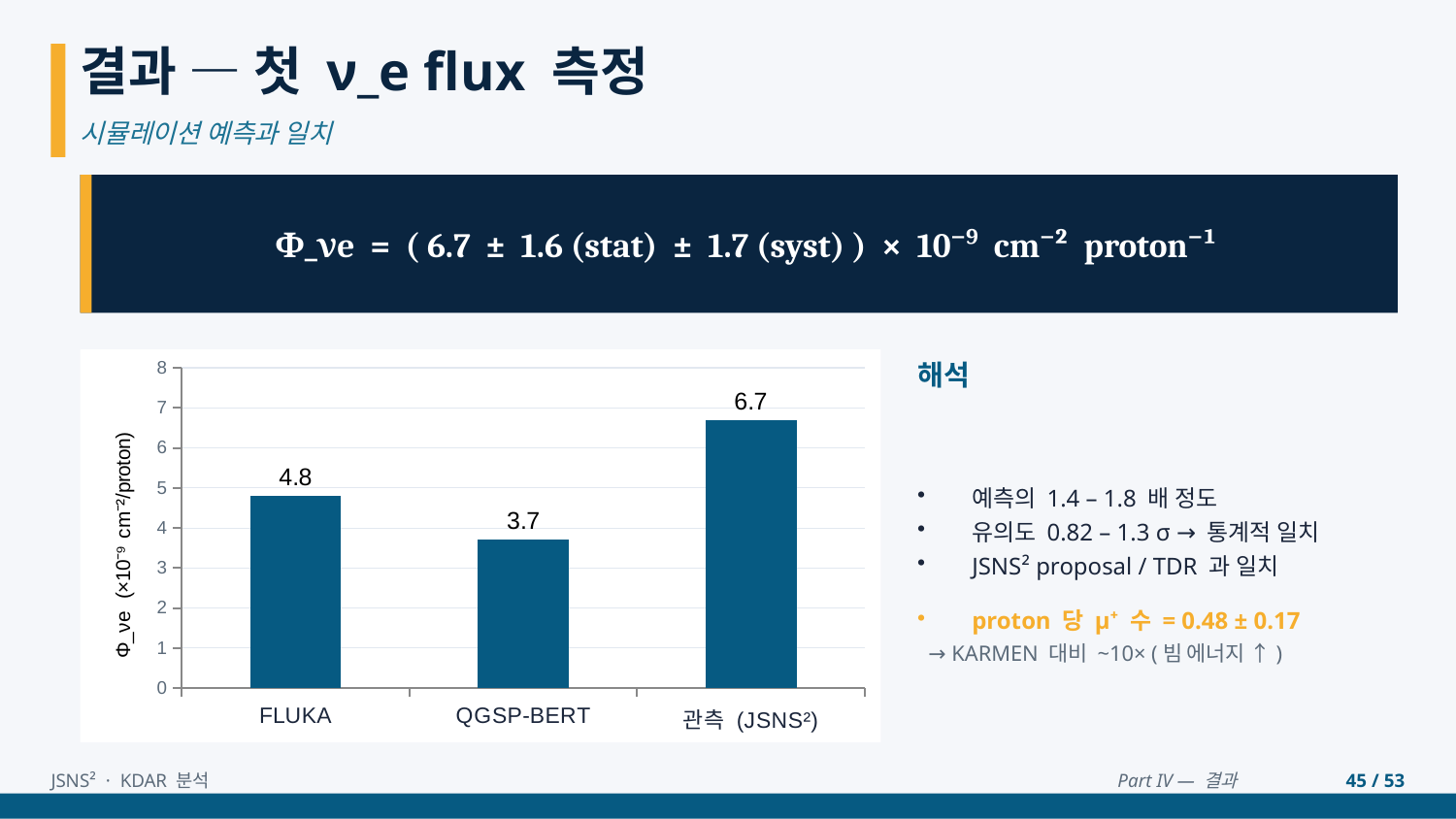
What is the difference between the values for FLUKA and QGSP-BERT? 1.1 What kind of chart is shown on the slide? bar chart Which is larger, the value for FLUKA or the value for QGSP-BERT? FLUKA What is the label of the y axis? Φ_νe (×10⁻⁹ cm⁻²/proton) Is the value for 관측 (JSNS²) greater or less than 6? greater What is the value for QGSP-BERT? 3.7 What is the value for FLUKA? 4.8 What is the value for 관측 (JSNS²)? 6.7 How many categories are shown on the x axis? 3 What is the difference between the values for 관측 (JSNS²) and FLUKA? 1.9 Which category has the lowest value? QGSP-BERT Which category has the highest value? 관측 (JSNS²)